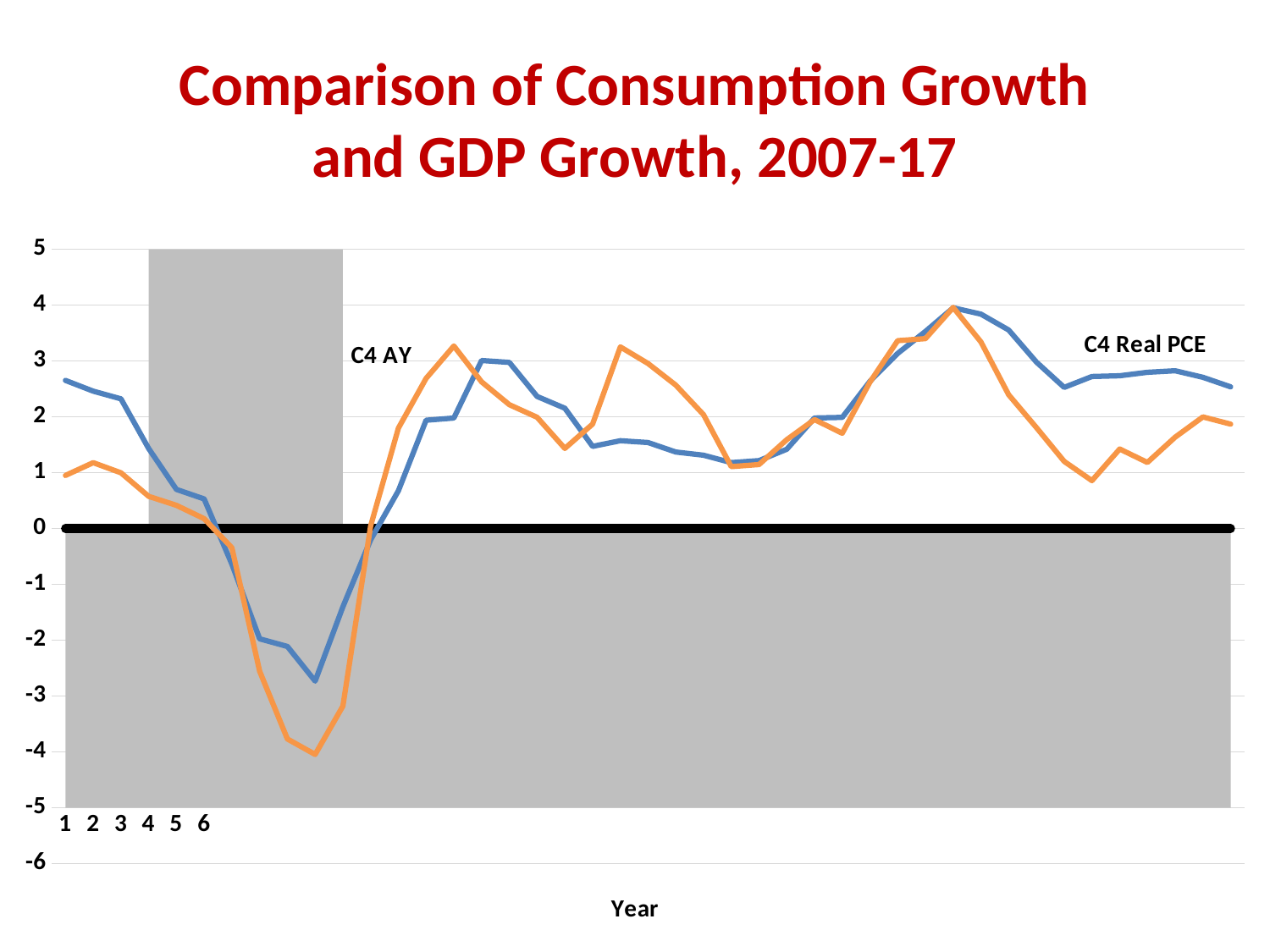
What is the highest tick value shown on the vertical axis? 5 How many data series are plotted on the chart? 2 Which series reaches the lowest value on the chart, C4 AY or C4 Real PCE? C4 AY What is the title of the chart? Comparison of Consumption Growth and GDP Growth, 2007-17 At year 1, which series has the larger value, C4 AY or C4 Real PCE? C4 Real PCE Is the lowest value of the C4 Real PCE series greater or less than -3? greater Is the value of C4 Real PCE at year 1 greater or less than 2? greater What kind of chart is shown on the slide? line chart What is the label of the horizontal axis? Year Is the lowest value of the C4 AY series greater or less than -3? less Do the values of both series rise or fall between year 3 and year 6? fall